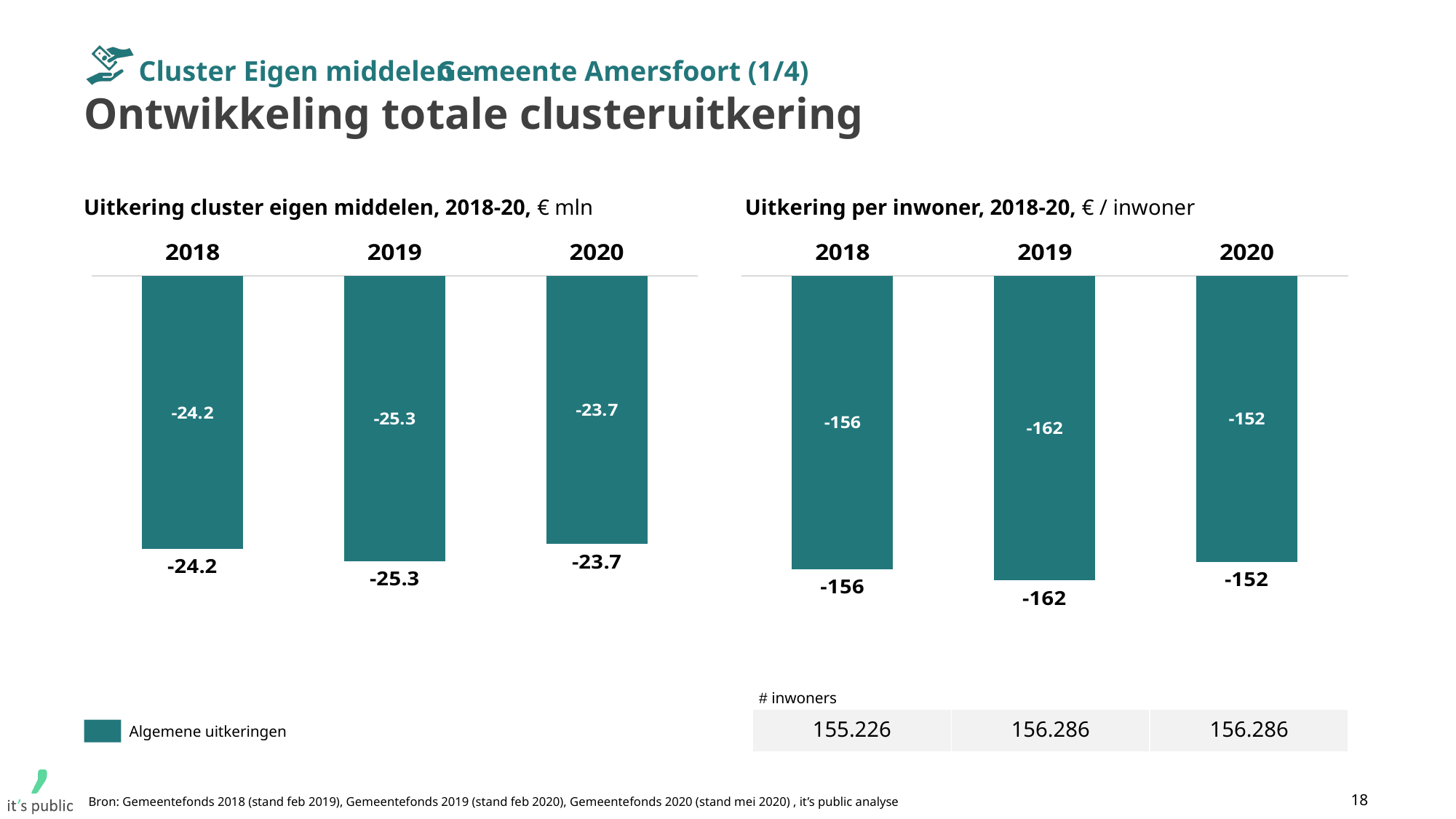
In the chart 'Uitkering cluster eigen middelen, 2018-20', what is the value for 2018? -24.2 In the chart 'Uitkering per inwoner, 2018-20', what is the value for 2020? -152 In the chart 'Uitkering per inwoner, 2018-20', which year has the lowest (most negative) value? 2019 In the chart 'Uitkering cluster eigen middelen, 2018-20', what is the value for 2019? -25.3 How many years are shown in the chart 'Uitkering cluster eigen middelen, 2018-20'? 3 In the chart 'Uitkering per inwoner, 2018-20', which year has the larger (less negative) value, 2018 or 2019? 2018 In the chart 'Uitkering cluster eigen middelen, 2018-20', which year has the highest (least negative) value? 2020 What is the name of the series shown in the legend? Algemene uitkeringen In the chart 'Uitkering cluster eigen middelen, 2018-20', what is the difference between the 2018 and 2019 values? 1.1 How many series does the legend on the slide list? 1 What kind of chart is 'Uitkering per inwoner, 2018-20'? Bar chart In the chart 'Uitkering per inwoner, 2018-20', what is the difference between the 2019 and 2020 values? 10